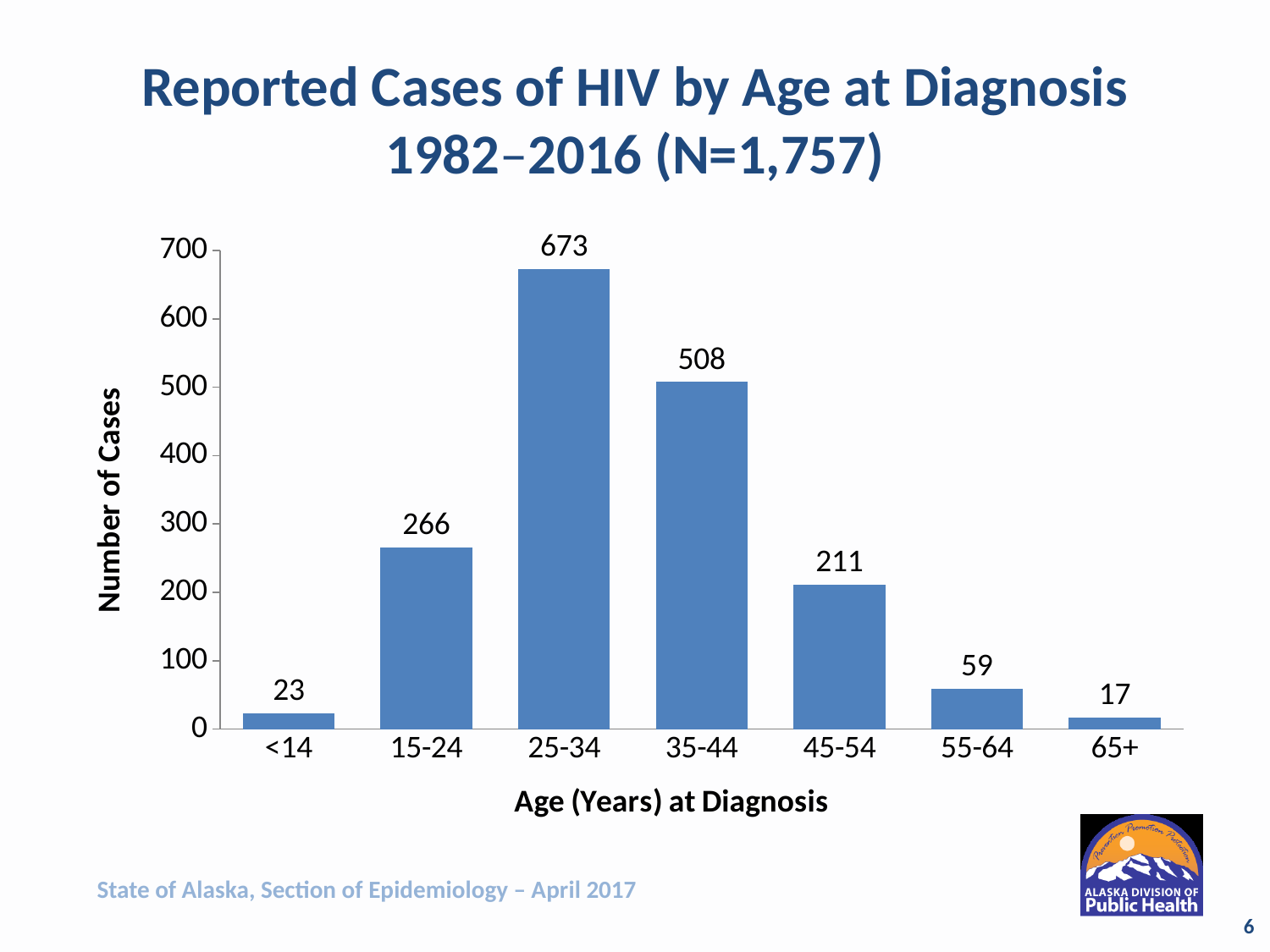
Is the value for the 35-44 age group greater or less than 500? greater Which age group has more reported cases, 15-24 or 45-54? 15-24 What is the difference in number of cases between the 25-34 and 35-44 age groups? 165 What is the label of the y axis? Number of Cases What kind of chart is shown on the slide? Bar chart Which age group has the lowest number of reported HIV cases? 65+ What is the difference in number of cases between the 15-24 and 45-54 age groups? 55 How many age groups are shown on the x axis? 7 How many cases were reported for the <14 age group? 23 How many reported HIV cases were diagnosed in the 25-34 age group? 673 Which age group has the highest number of reported HIV cases? 25-34 What is the number of cases for the 55-64 age group? 59